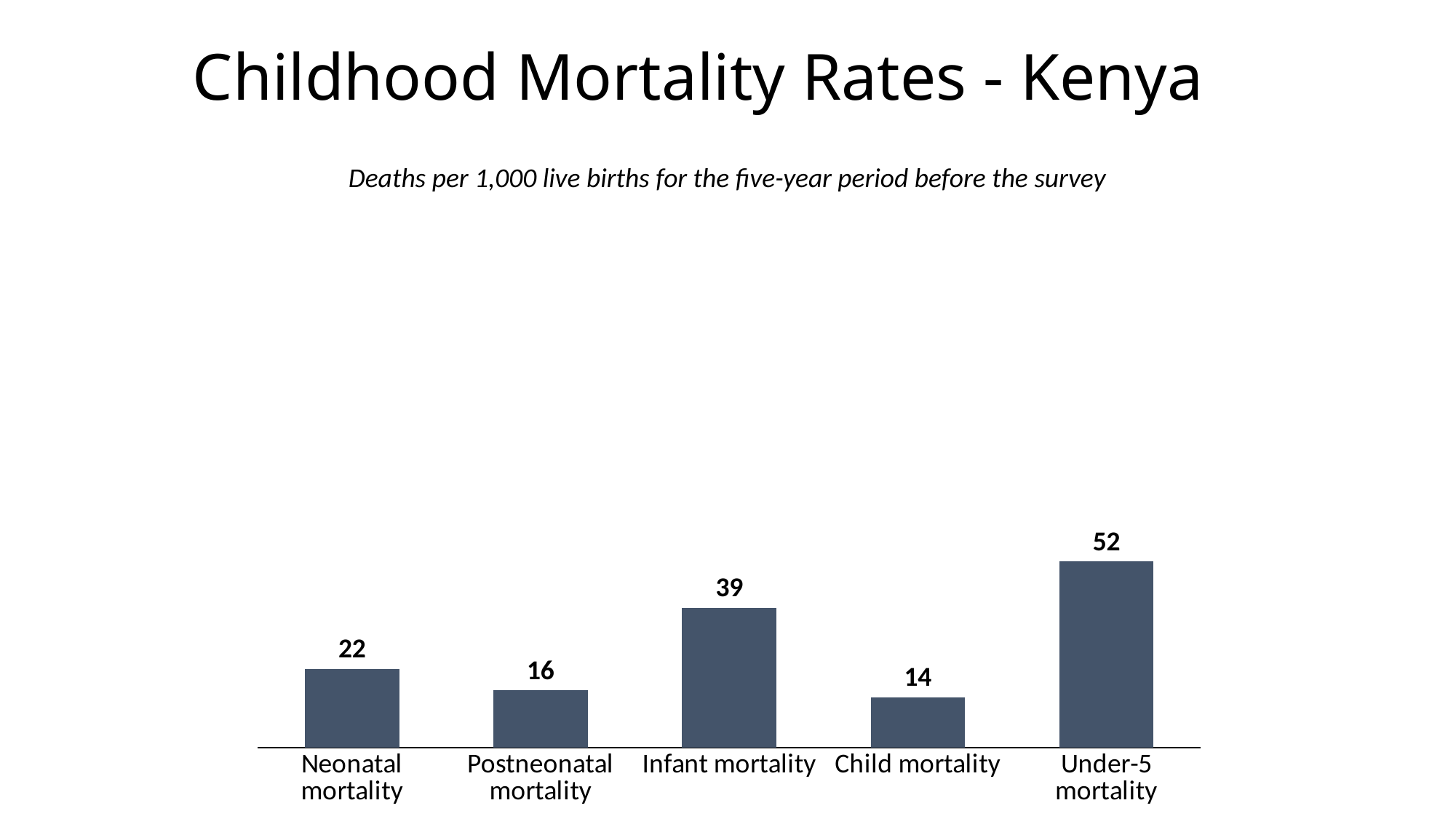
Which category has the highest value? Under-5 mortality What is the value for Child mortality? 14 What is the title of the slide? Childhood Mortality Rates - Kenya Which category has the lowest value? Child mortality What is the value for Neonatal mortality? 22 What is the difference between Under-5 mortality and Infant mortality? 13 Which is larger, Neonatal mortality or Postneonatal mortality? Neonatal mortality How many categories are shown in the chart? 5 What is the value for Under-5 mortality? 52 What is the value for Infant mortality? 39 What is the value for Postneonatal mortality? 16 What kind of chart is shown on the slide? Bar chart